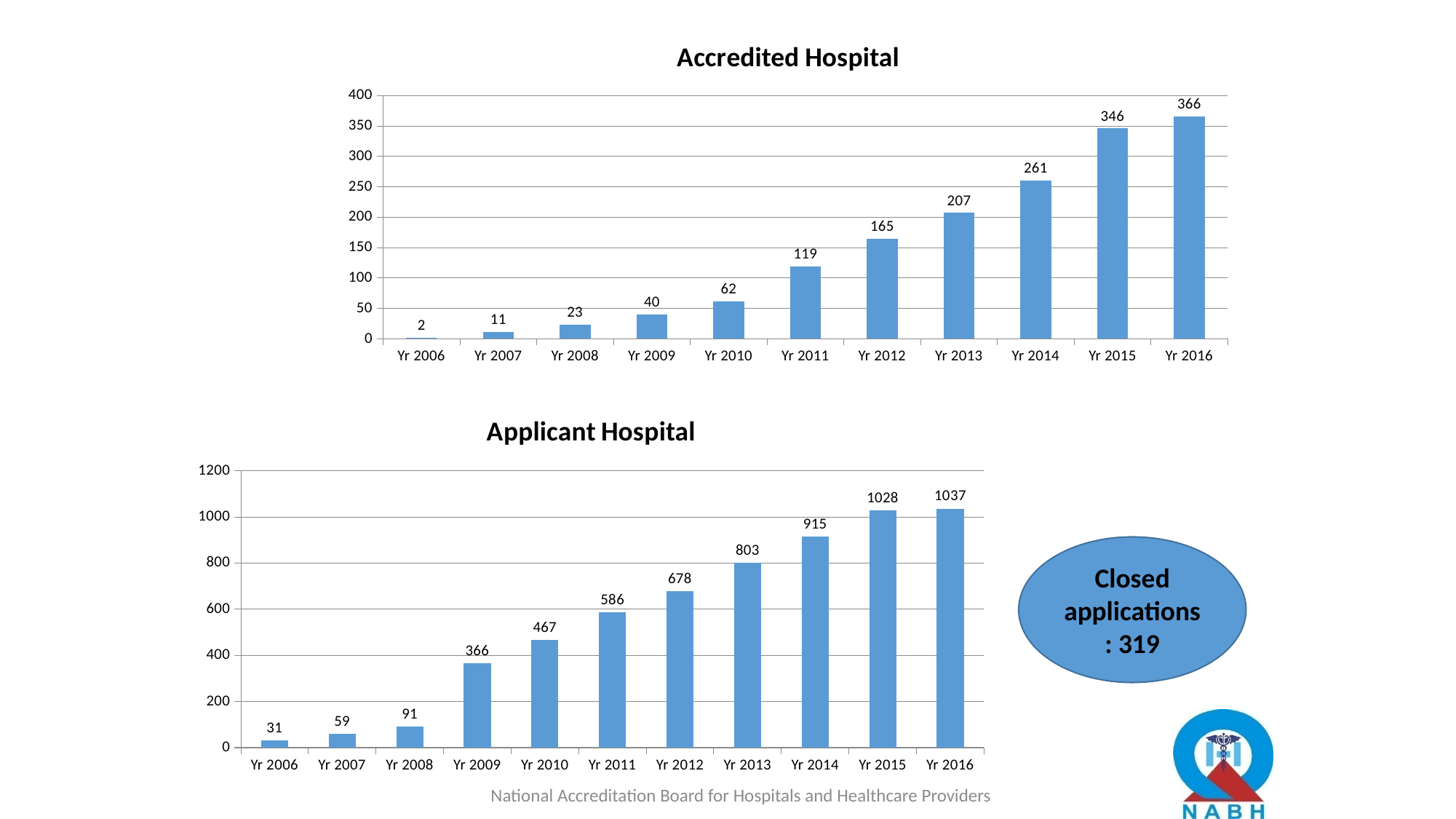
In the Applicant Hospital chart, do the values rise or fall from Yr 2006 to Yr 2016? rise In the Applicant Hospital chart, what is the value for Yr 2010? 467 In the Accredited Hospital chart, what is the value for Yr 2013? 207 What kind of chart is the Accredited Hospital chart? bar chart What is the title of the top chart on the slide? Accredited Hospital In the Applicant Hospital chart, which year has the lowest value? Yr 2006 In the Accredited Hospital chart, is the value for Yr 2014 greater or less than 250? greater In the Accredited Hospital chart, what is the difference between the values for Yr 2016 and Yr 2015? 20 In the Applicant Hospital chart, what is the difference between the values for Yr 2014 and Yr 2013? 112 In the Accredited Hospital chart, which year has the highest value? Yr 2016 In the Applicant Hospital chart, which is larger, the value for Yr 2009 or the value for Yr 2008? Yr 2009 How many years are shown on the x axis of the Applicant Hospital chart? 11